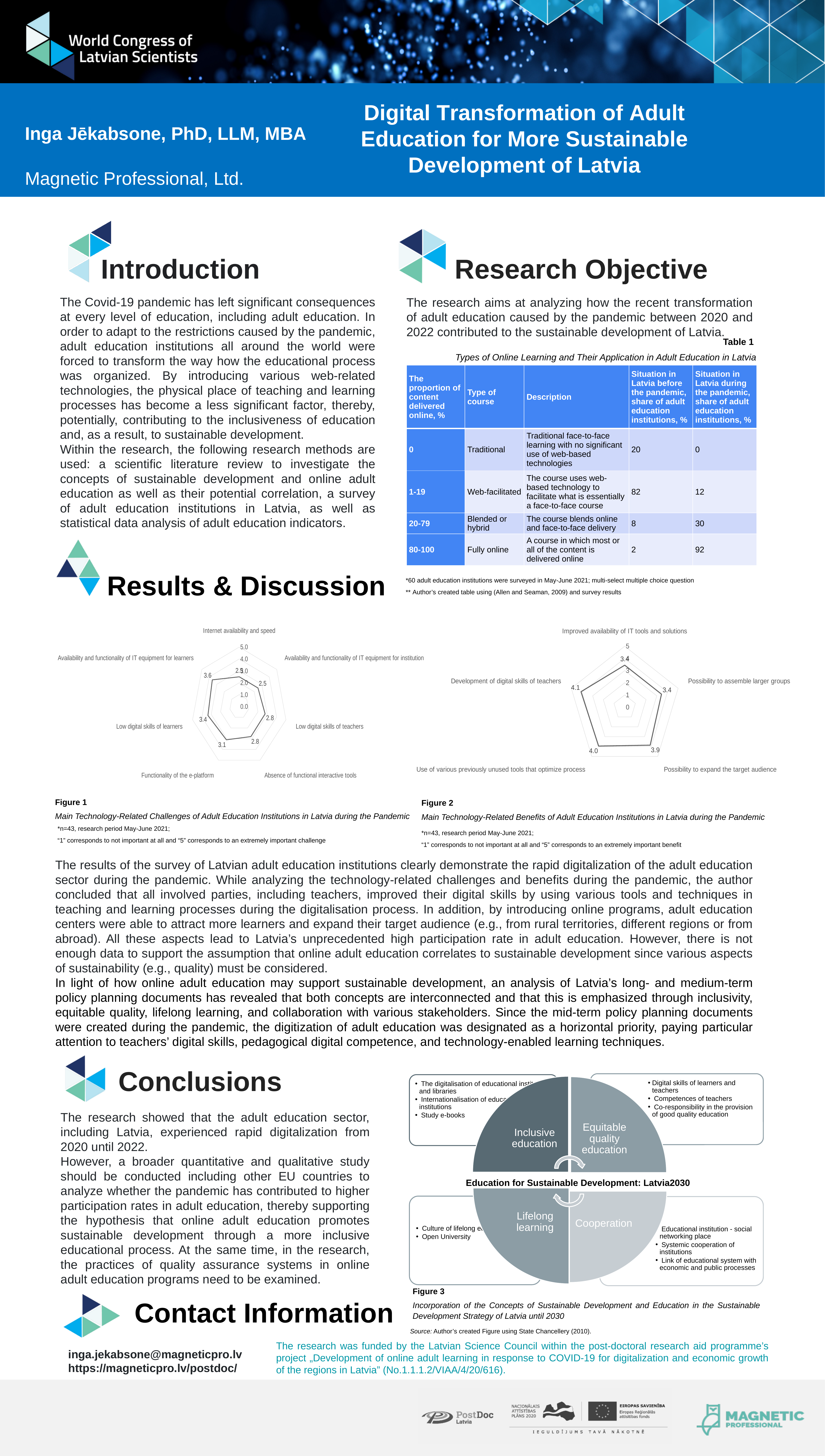
In Figure 1 (Main Technology-Related Challenges), how many challenge categories are plotted? 7 In Figure 2 (Main Technology-Related Benefits), how many benefit categories are plotted? 5 In Figure 1 (Main Technology-Related Challenges), what is the value for Availability and functionality of IT equipment for learners? 3.6 In Figure 1 (Main Technology-Related Challenges), what is the difference between Low digital skills of learners and Low digital skills of teachers? 0.6 In Figure 1 (Main Technology-Related Challenges), what is the value for Functionality of the e-platform? 3.1 In Figure 1 (Main Technology-Related Challenges), which challenge has the highest value? Availability and functionality of IT equipment for learners In Figure 2 (Main Technology-Related Benefits), which benefit has the highest value? Development of digital skills of teachers In Figure 1 (Main Technology-Related Challenges), which is larger: Functionality of the e-platform or Absence of functional interactive tools? Functionality of the e-platform In Figure 2 (Main Technology-Related Benefits), what is the difference between Use of various previously unused tools that optimize process and Possibility to assemble larger groups? 0.6 What kind of chart is Figure 2 (Main Technology-Related Benefits)? Radar chart In Figure 2 (Main Technology-Related Benefits), what is the value for Development of digital skills of teachers? 4.1 In Figure 2 (Main Technology-Related Benefits), what is the value for Possibility to expand the target audience? 3.9